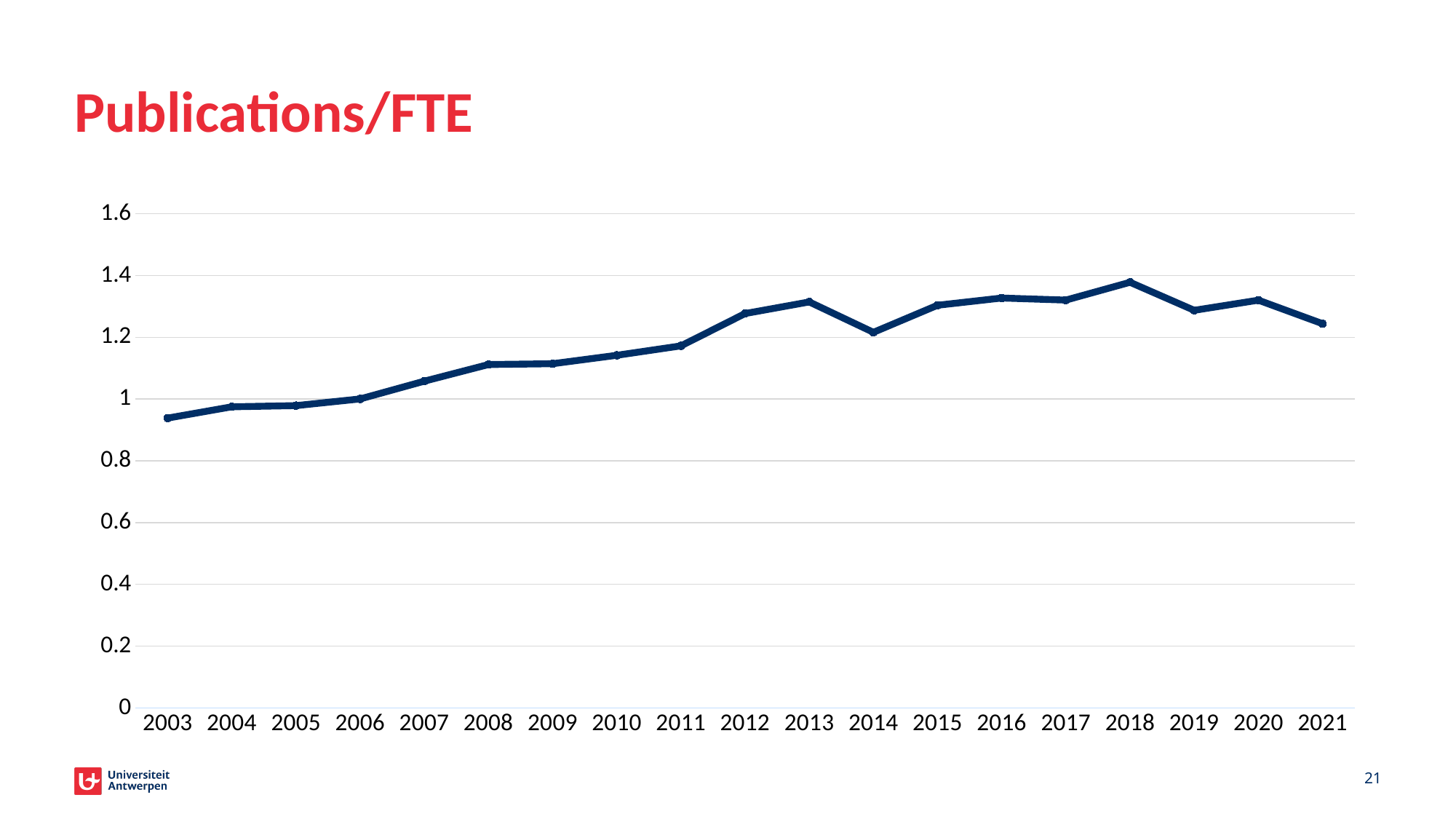
Is the value for 2012 greater or less than 1.2? greater What is the title of the chart? Publications/FTE Which year has the lowest Publications/FTE value? 2003 Which year has the larger value, 2003 or 2021? 2021 Is the value for 2008 greater or less than 1? greater Is the value for 2003 greater or less than 1? less Do the values generally rise or fall from 2003 to 2013? rise Which year has the highest Publications/FTE value? 2018 What kind of chart is shown on the slide? line chart How many years are plotted on the x axis? 19 Which year has the larger value, 2013 or 2014? 2013